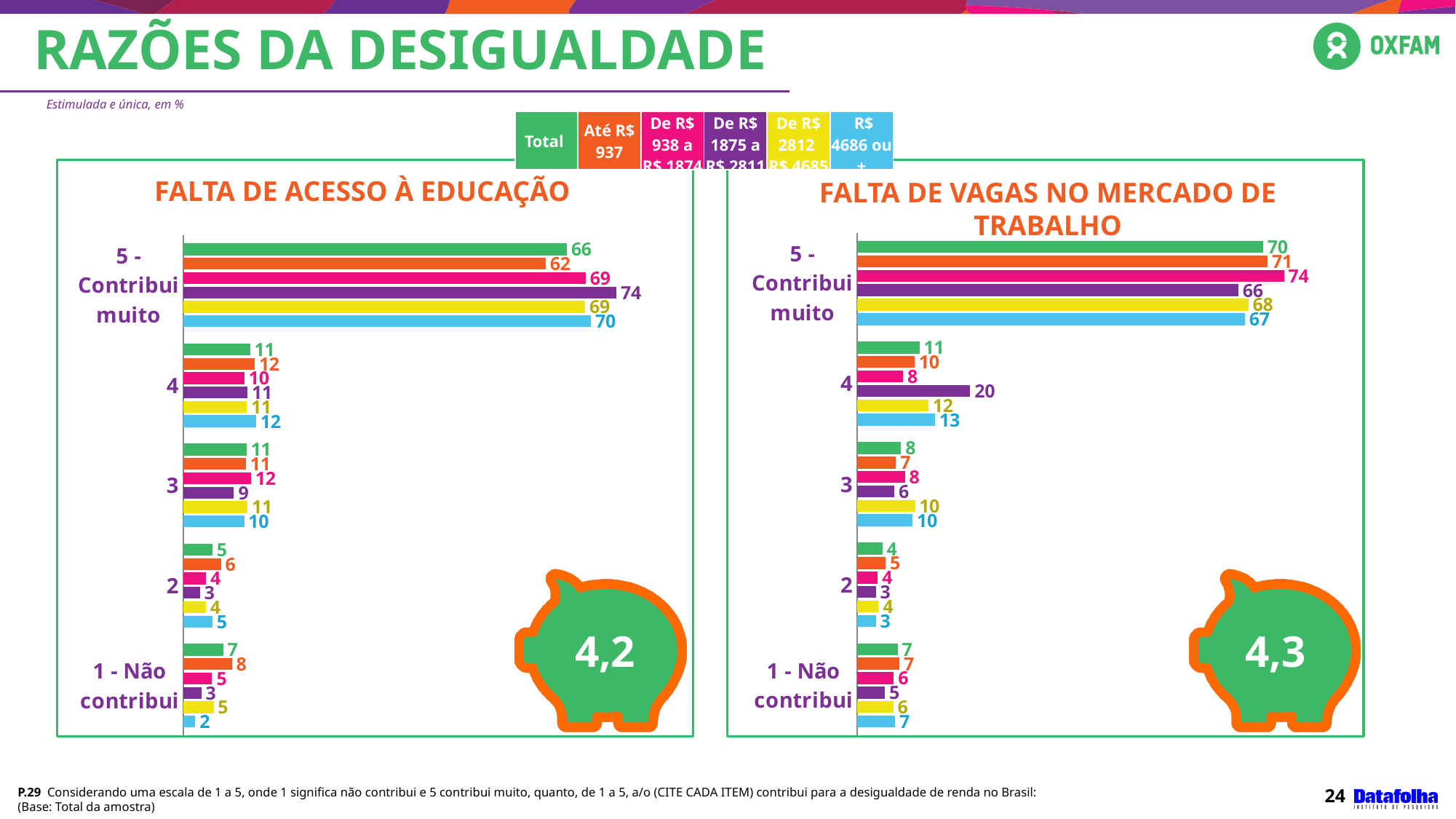
In the chart 'FALTA DE ACESSO À EDUCAÇÃO', which income group has the highest value for '5 - Contribui muito'? De R$ 1875 a R$ 2811 What kind of chart is 'FALTA DE VAGAS NO MERCADO DE TRABALHO'? Bar chart In the chart 'FALTA DE VAGAS NO MERCADO DE TRABALHO', what is the difference between the Total value for '5 - Contribui muito' and the Total value for '1 - Não contribui'? 63 In the chart 'FALTA DE ACESSO À EDUCAÇÃO', what is the Total value for '5 - Contribui muito'? 66 What number is shown inside the piggy bank icon on the chart 'FALTA DE ACESSO À EDUCAÇÃO'? 4,2 In the chart 'FALTA DE VAGAS NO MERCADO DE TRABALHO', what is the difference between the 'De R$ 938 a R$ 1874' value and the 'De R$ 1875 a R$ 2811' value for '5 - Contribui muito'? 8 In the chart 'FALTA DE ACESSO À EDUCAÇÃO', which income group has the lowest value for '1 - Não contribui'? R$ 4686 ou + In the chart 'FALTA DE VAGAS NO MERCADO DE TRABALHO', what is the value for 'De R$ 1875 a R$ 2811' at category 4? 20 In the chart 'FALTA DE VAGAS NO MERCADO DE TRABALHO', which is larger for '5 - Contribui muito': the Total value or the 'Até R$ 937' value? Até R$ 937 How many categories are shown on the y axis of the chart 'FALTA DE ACESSO À EDUCAÇÃO'? 5 In the chart 'FALTA DE ACESSO À EDUCAÇÃO', what is the 'Até R$ 937' value for '1 - Não contribui'? 8 How many series does the legend list? 6